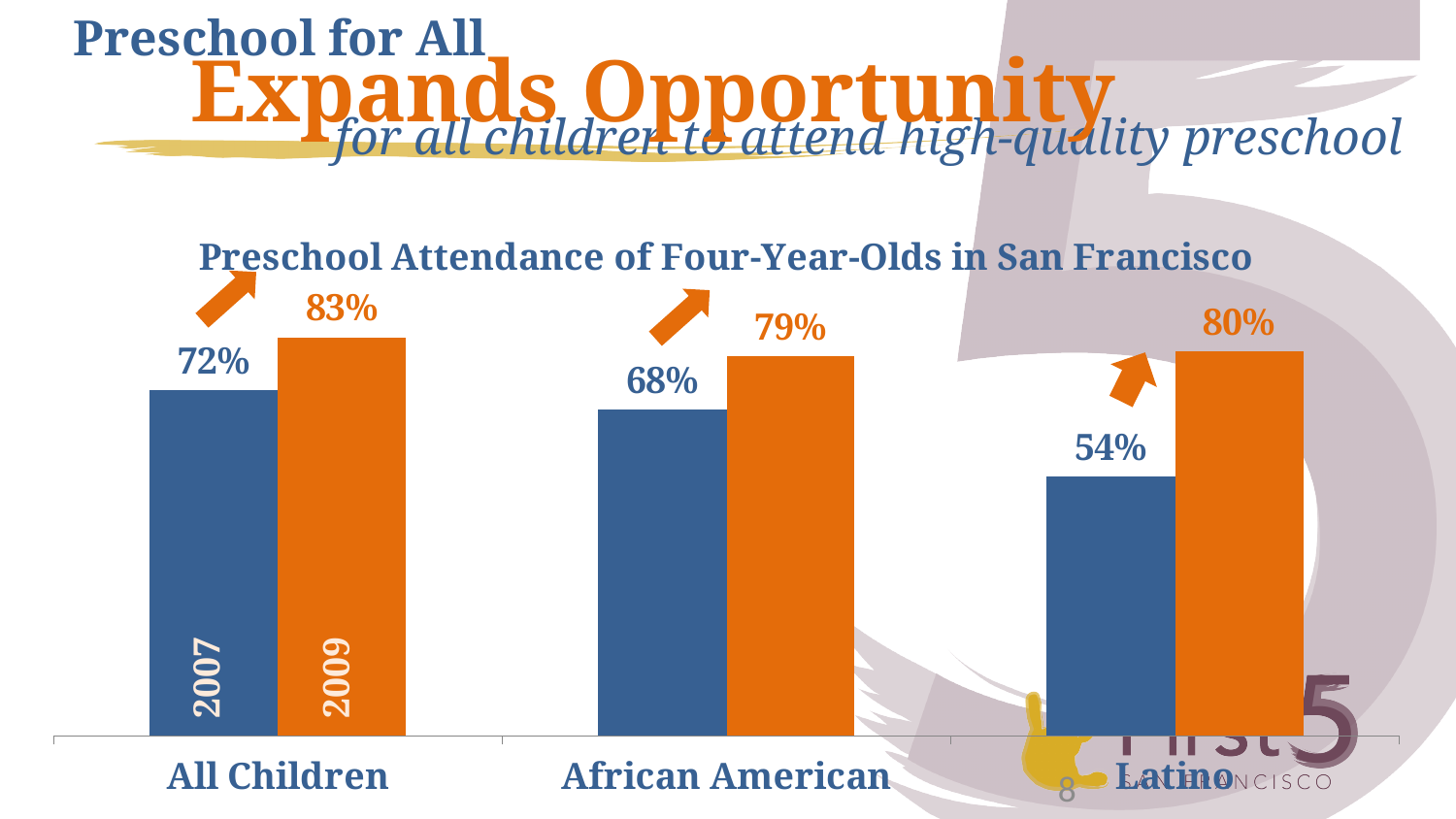
How many years (series) are compared for each group in the chart? 2 Which is larger: the 2007 attendance rate for African American children or the 2007 rate for Latino children? African American What is the difference between the 2007 and 2009 attendance rates for All Children? 11 percentage points What type of chart is used to show preschool attendance? Bar chart What was the preschool attendance rate for All Children in 2009? 83% How many groups are shown on the x axis of the chart? 3 What is the title of the chart? Preschool Attendance of Four-Year-Olds in San Francisco Which group had the lowest preschool attendance rate in 2007? Latino By how many percentage points did Latino preschool attendance increase from 2007 to 2009? 26 percentage points Which group had the highest preschool attendance rate in 2009? All Children What was the preschool attendance rate for African American four-year-olds in 2009? 79% What was the preschool attendance rate for Latino four-year-olds in 2007? 54%